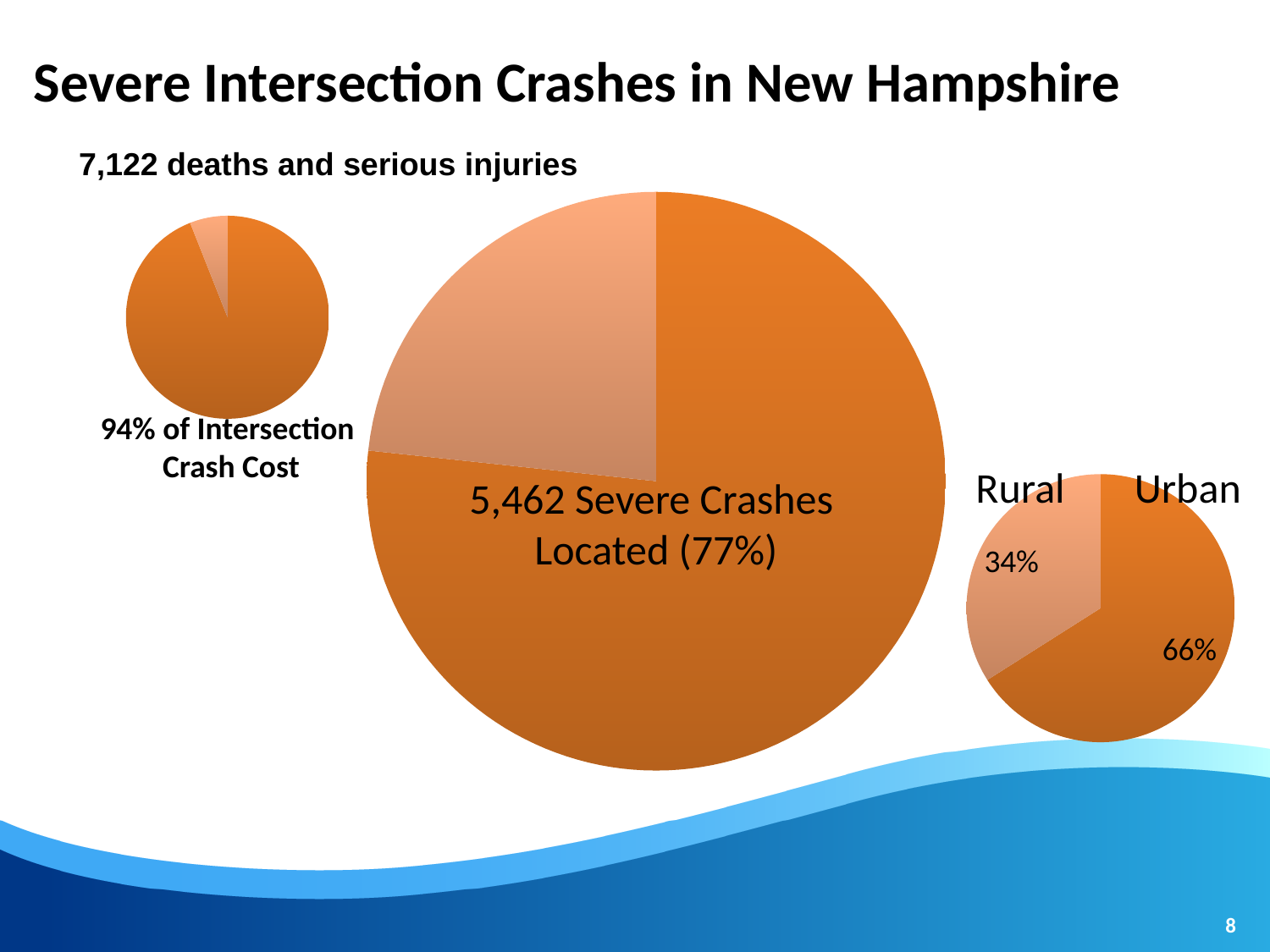
What is the title of the slide? Severe Intersection Crashes in New Hampshire In the large central pie chart, what percentage of severe crashes were located? 77% How many pie charts are on the slide? 3 In the small pie chart on the left, what percentage of intersection crash cost does the large slice represent? 94% How many deaths and serious injuries does the slide subtitle report? 7,122 In the Rural/Urban pie chart on the right, what share is Urban? 66% In the large central pie chart, how many severe crashes were located? 5,462 How many slices does the Rural/Urban pie chart on the right have? 2 What kind of charts are shown on the slide? Pie charts In the Rural/Urban pie chart on the right, what share is Rural? 34% In the Rural/Urban pie chart on the right, what is the difference between the Urban and Rural shares? 32 percentage points In the Rural/Urban pie chart on the right, which slice is larger, Rural or Urban? Urban